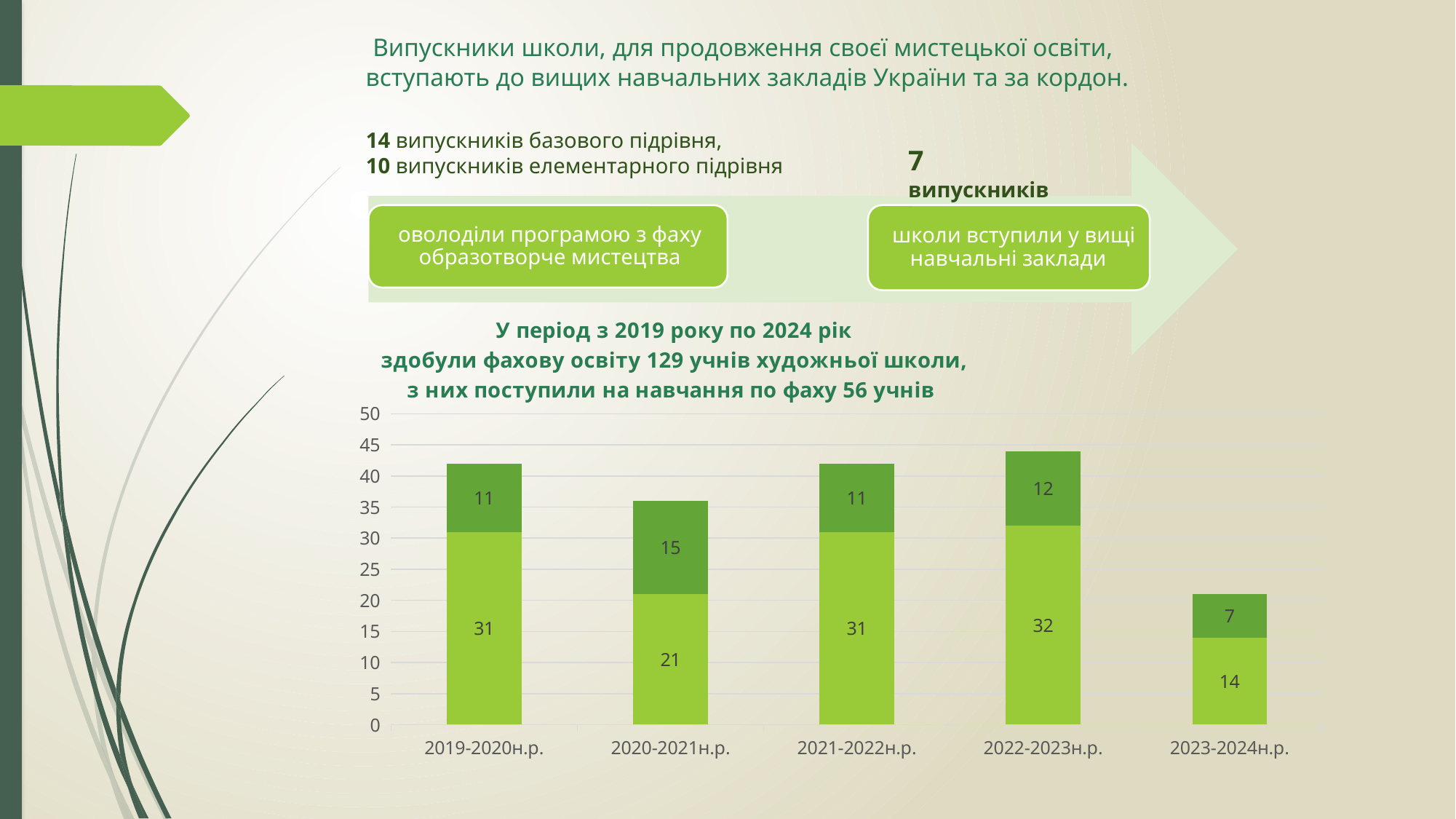
What is the difference between the lower (light green) segment values for 2022-2023н.р. and 2023-2024н.р.? 18 Which school year has the tallest stacked bar overall? 2022-2023н.р. What is the value of the lower (light green) segment for 2019-2020н.р.? 31 What is the total height of the stacked bar for 2022-2023н.р.? 44 What kind of chart is shown on the slide? stacked bar chart Which school year has the shortest stacked bar overall? 2023-2024н.р. How many school-year categories are shown on the x axis of the chart? 5 What is the value of the upper (dark green) segment for 2022-2023н.р.? 12 What is the total height of the stacked bar for 2023-2024н.р.? 21 What is the value of the lower (light green) segment for 2020-2021н.р.? 21 Which has the larger upper (dark green) segment: 2020-2021н.р. or 2019-2020н.р.? 2020-2021н.р. Is the total height of the stacked bar for 2020-2021н.р. greater or less than 40? less